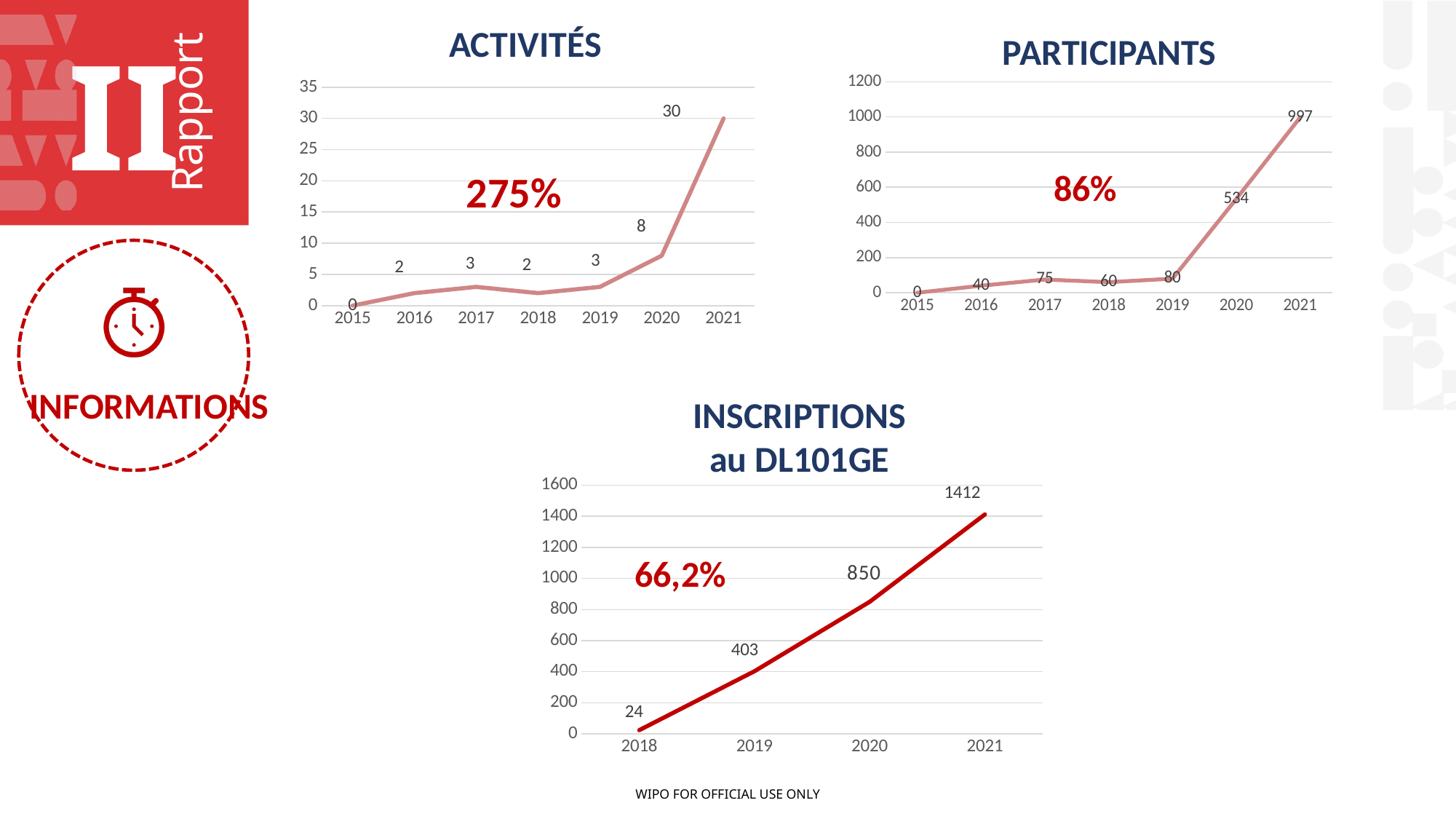
In the INSCRIPTIONS au DL101GE chart, do the values rise or fall from 2018 to 2021? rise In the PARTICIPANTS chart, is the value for 2017 larger or the value for 2018? 2017 In the ACTIVITÉS chart, how many years are plotted on the x axis? 7 In the ACTIVITÉS chart, which year has the lowest value? 2015 In the PARTICIPANTS chart, what is the value for 2020? 534 What kind of chart is the INSCRIPTIONS au DL101GE chart? line chart In the INSCRIPTIONS au DL101GE chart, what is the value for 2019? 403 In the ACTIVITÉS chart, what is the value for 2020? 8 In the ACTIVITÉS chart, what is the value for 2021? 30 In the PARTICIPANTS chart, which year has the highest value? 2021 In the PARTICIPANTS chart, what is the difference between the values for 2021 and 2020? 463 In the INSCRIPTIONS au DL101GE chart, what is the difference between the values for 2021 and 2020? 562